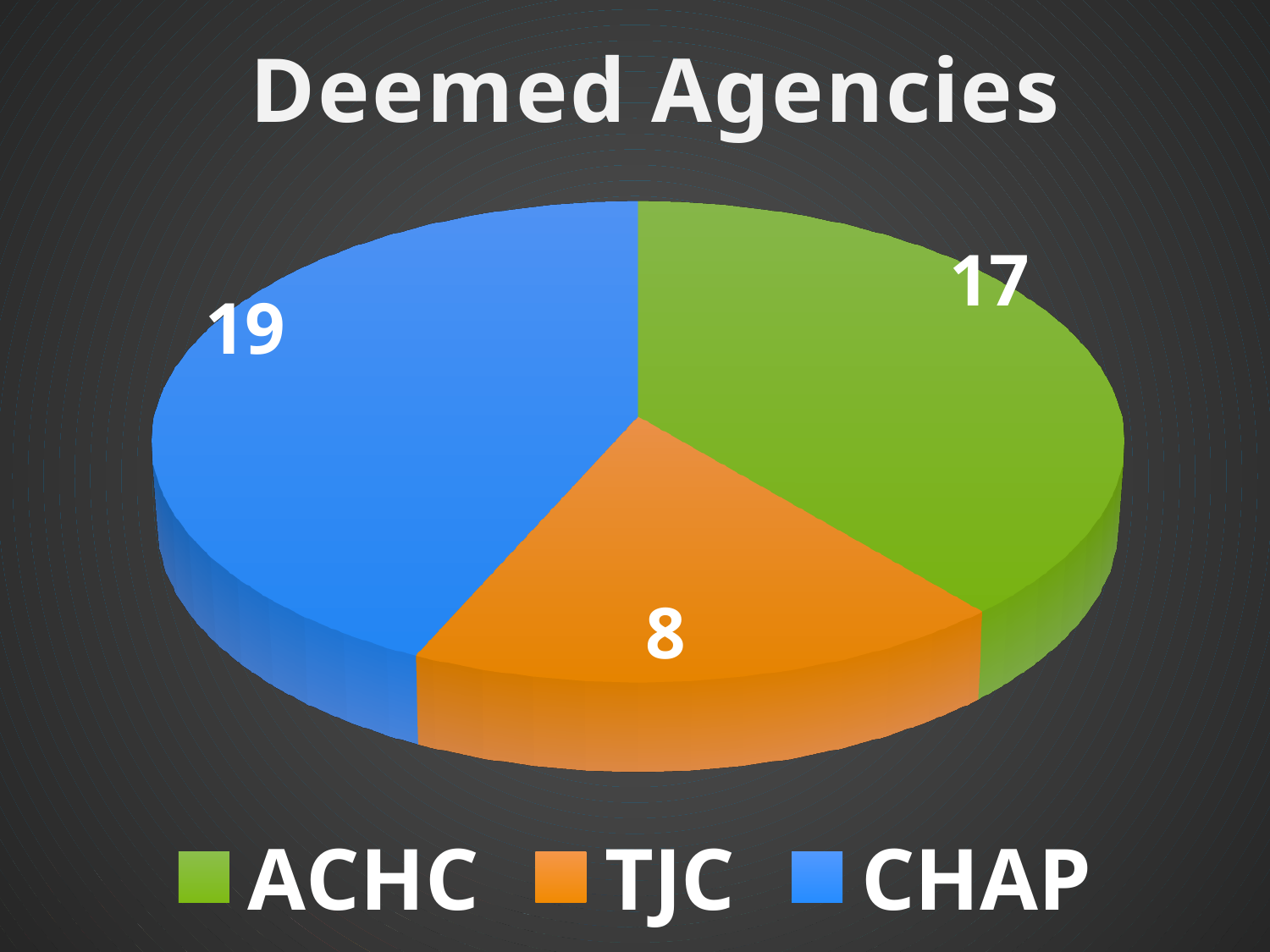
What is the value for CHAP? 19 Which agency has the smallest slice? TJC What kind of chart is shown on the slide? Pie chart Which agency has the largest slice? CHAP Which is larger, the value for ACHC or the value for TJC? ACHC What is the difference between the values for CHAP and TJC? 11 What is the title of the chart? Deemed Agencies What is the value for TJC? 8 What is the value for ACHC? 17 What is the total of all slices in the pie chart? 44 What is the difference between the values for CHAP and ACHC? 2 How many slices does the pie chart have? 3